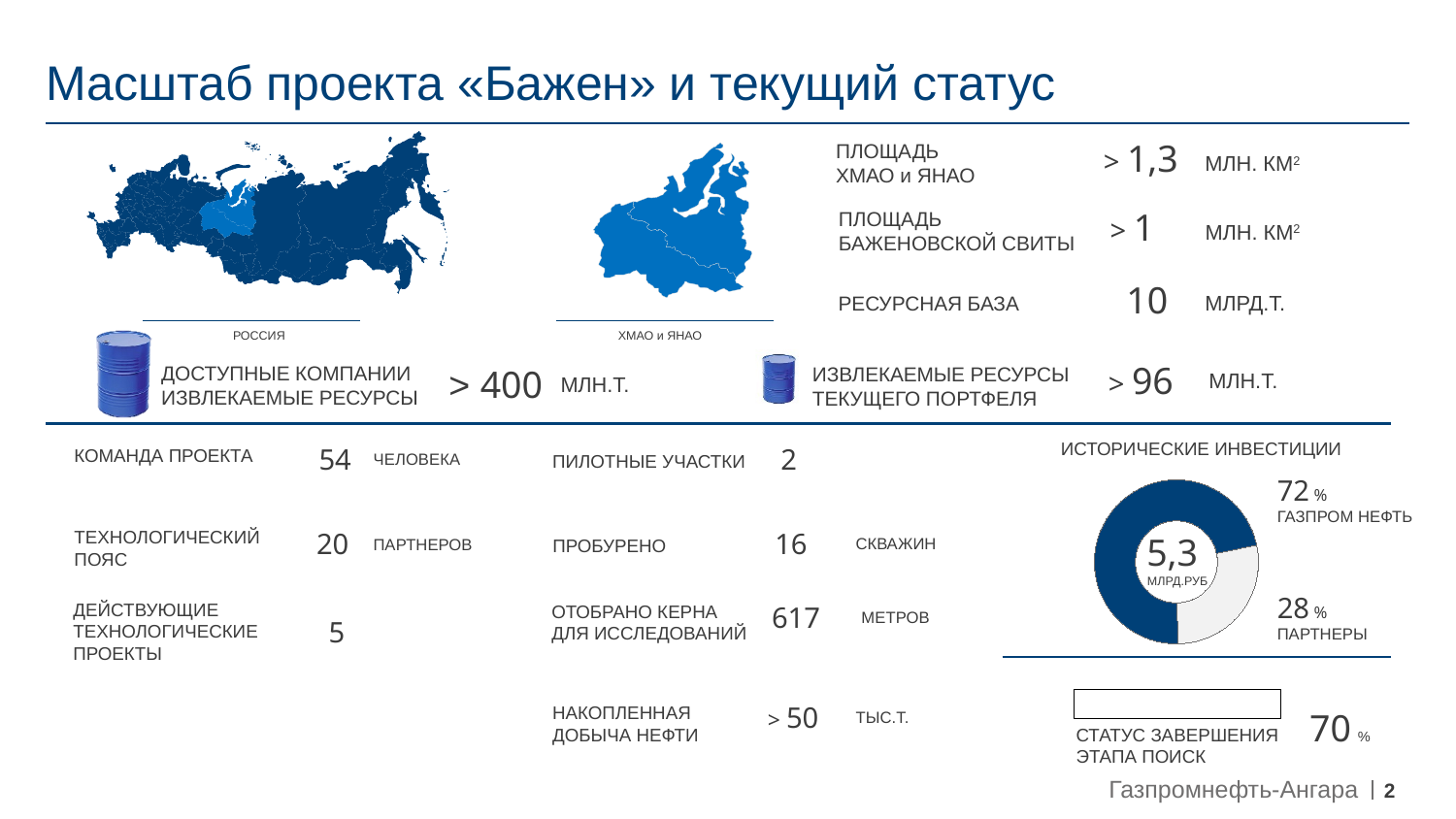
In the «ИСТОРИЧЕСКИЕ ИНВЕСТИЦИИ» chart, how many segments does the donut have? 2 In the «ИСТОРИЧЕСКИЕ ИНВЕСТИЦИИ» chart, by how many percentage points does the ГАЗПРОМ НЕФТЬ share exceed the ПАРТНЕРЫ share? 44 percentage points In the «ИСТОРИЧЕСКИЕ ИНВЕСТИЦИИ» chart, which segment is the smallest? ПАРТНЕРЫ In the «ИСТОРИЧЕСКИЕ ИНВЕСТИЦИИ» chart, what share is attributed to ПАРТНЕРЫ? 28% What is the title of the donut chart on the slide? ИСТОРИЧЕСКИЕ ИНВЕСТИЦИИ In the «ИСТОРИЧЕСКИЕ ИНВЕСТИЦИИ» chart, what share is attributed to ГАЗПРОМ НЕФТЬ? 72% What total value is printed in the centre of the «ИСТОРИЧЕСКИЕ ИНВЕСТИЦИИ» donut chart? 5,3 МЛРД.РУБ What kind of chart is shown under the heading «ИСТОРИЧЕСКИЕ ИНВЕСТИЦИИ»? Donut (pie) chart In the «ИСТОРИЧЕСКИЕ ИНВЕСТИЦИИ» chart, which is larger: the share of ГАЗПРОМ НЕФТЬ or the share of ПАРТНЕРЫ? ГАЗПРОМ НЕФТЬ In the «ИСТОРИЧЕСКИЕ ИНВЕСТИЦИИ» chart, what colour is the ГАЗПРОМ НЕФТЬ segment? Dark blue In the «ИСТОРИЧЕСКИЕ ИНВЕСТИЦИИ» chart, which segment is the largest? ГАЗПРОМ НЕФТЬ